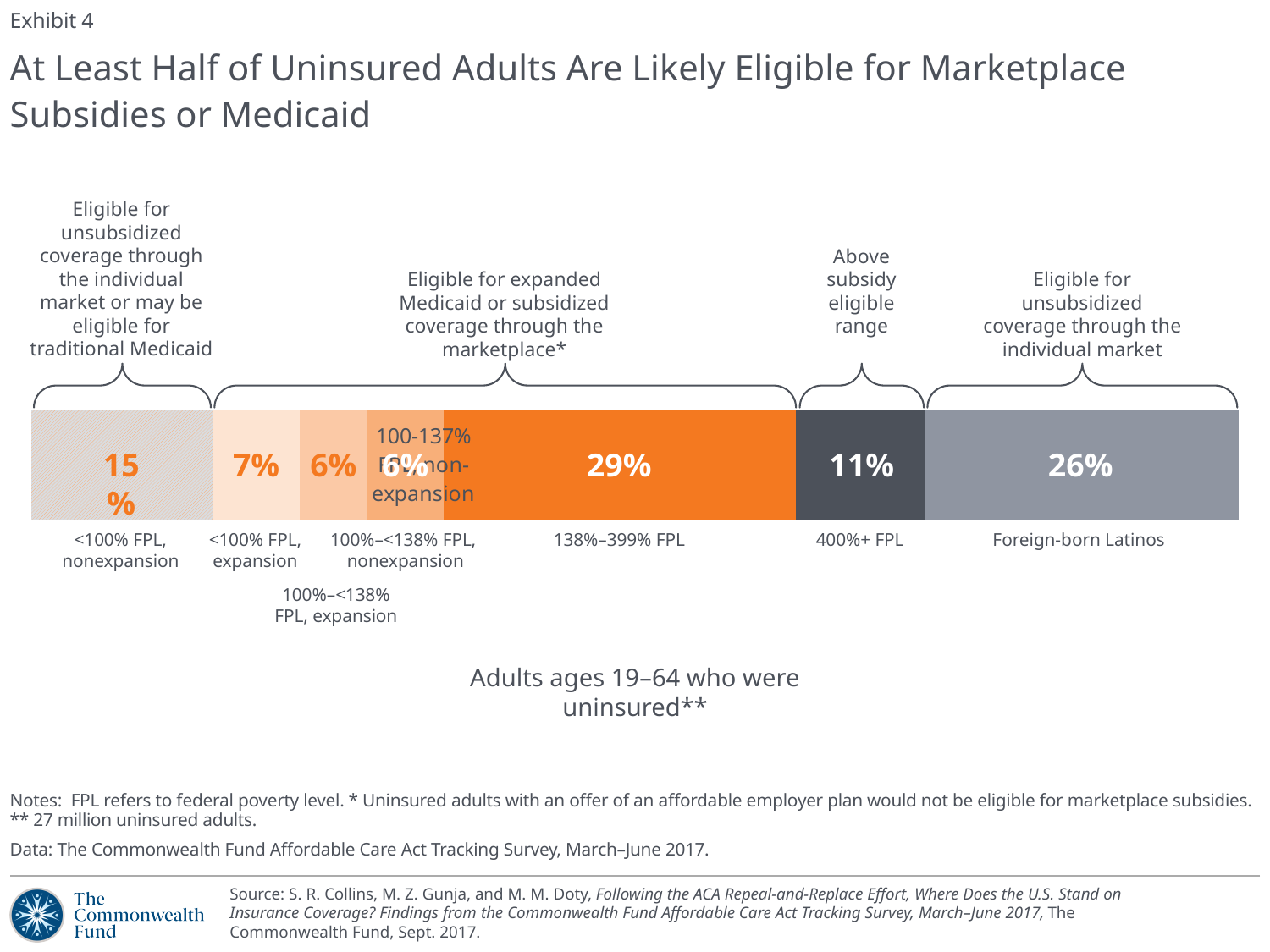
What is the value for the <100% FPL, nonexpansion segment? 15% Which segment of the bar has the largest share of uninsured adults? 138%–399% FPL Which is larger: the share for Foreign-born Latinos or the share for 400%+ FPL? Foreign-born Latinos What percentage of uninsured adults are at 400%+ FPL? 11% How many segments make up the stacked bar? 7 What is the difference between the Foreign-born Latinos share and the <100% FPL, nonexpansion share? 11 percentage points What share of uninsured adults are foreign-born Latinos? 26% What percentage of uninsured adults are in the 138%–399% FPL group? 29% What is the value for the <100% FPL, expansion segment? 7% What kind of chart is shown on the slide? Stacked bar chart What do all the segments of the stacked bar add up to? 100% What is the difference between the 138%–399% FPL share and the 400%+ FPL share? 18 percentage points